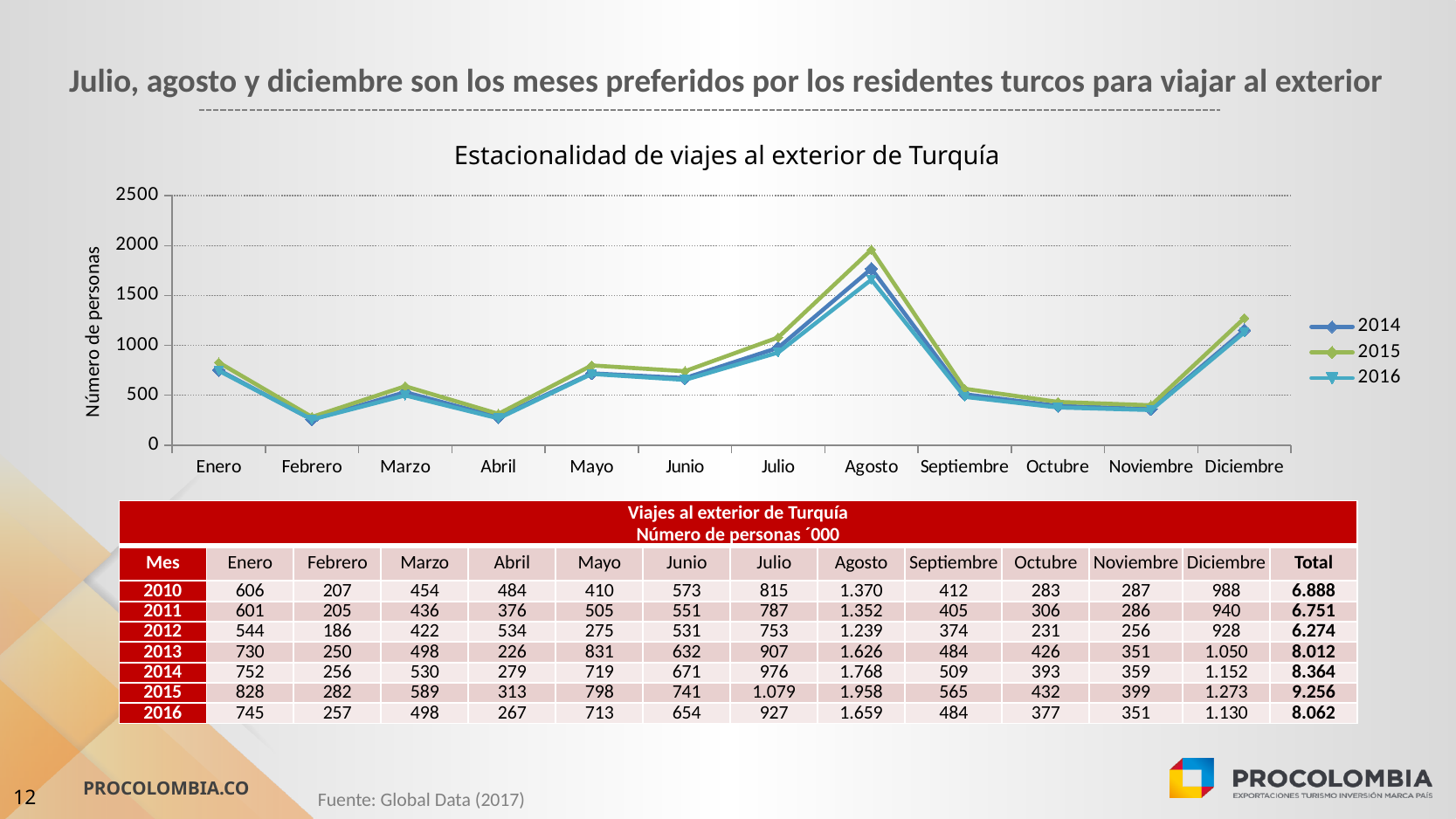
How many series does the chart legend list? 3 Which series has the larger value in Julio, 2015 or 2016? 2015 Is the value for Agosto in the 2016 series greater or less than 1500? greater What is the difference between the Agosto values for 2015 and 2014? 190 What is the value for Agosto in the 2015 series? 1.958 How many months are plotted along the x axis of the chart? 12 What is the title of the chart? Estacionalidad de viajes al exterior de Turquía What is the value for Diciembre in the 2016 series? 1.130 Do the values of the 2015 series rise or fall from Agosto to Septiembre? fall Which month has the lowest value for the 2014 series? Febrero Which month has the highest value for the 2015 series? Agosto What kind of chart is shown on the slide? line chart